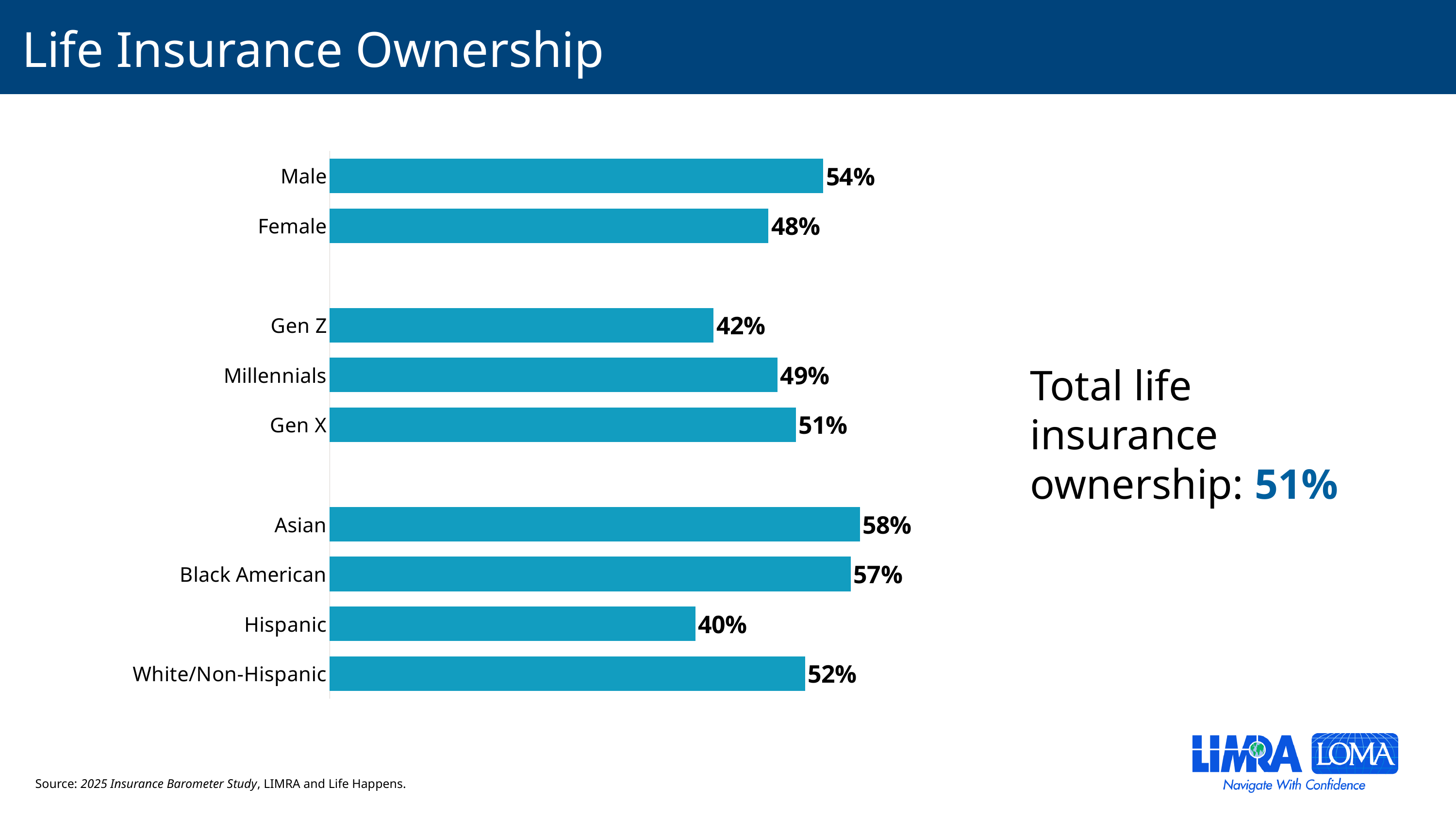
What is the life insurance ownership rate for Gen Z? 42% What is the difference between the ownership rates for Male and Female? 6% What is the difference between the ownership rates for Asian and Hispanic? 18% What total life insurance ownership rate is stated on the slide? 51% What is the life insurance ownership rate for Hispanic? 40% Which has a higher ownership rate, Millennials or Gen X? Gen X What kind of chart is shown on the slide? Bar chart Which category has the highest life insurance ownership rate? Asian Which category has the lowest life insurance ownership rate? Hispanic What is the life insurance ownership rate for Male? 54% What is the life insurance ownership rate for White/Non-Hispanic? 52% How many categories are shown in the chart? 9